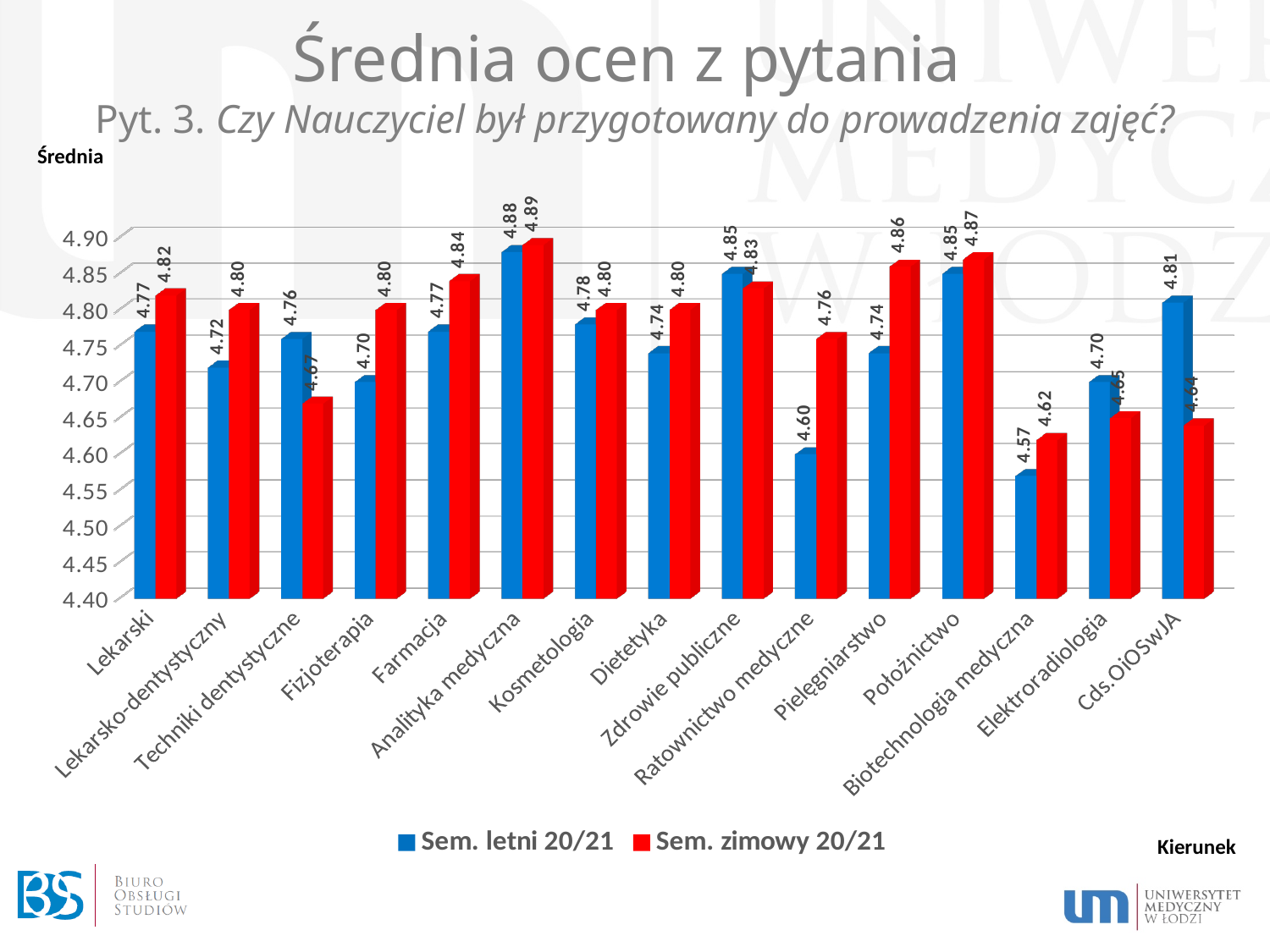
Which is larger for Zdrowie publiczne: the Sem. letni 20/21 value or the Sem. zimowy 20/21 value? Sem. letni 20/21 What is the difference between the Sem. zimowy 20/21 and Sem. letni 20/21 values for Ratownictwo medyczne? 0.16 Is the Sem. letni 20/21 value for Biotechnologia medyczna greater or less than 4.60? less What kind of chart is shown on the slide? bar chart How many series does the legend list? 2 What is the Sem. letni 20/21 value for Analityka medyczna? 4.88 Which category has the lowest Sem. letni 20/21 value? Biotechnologia medyczna What is the Sem. zimowy 20/21 value for Pielęgniarstwo? 4.86 How many categories (kierunki) are shown on the x axis? 15 What is the Sem. letni 20/21 value for Ratownictwo medyczne? 4.60 Which colour represents Sem. zimowy 20/21 in the chart? red Which category has the highest Sem. letni 20/21 value? Analityka medyczna